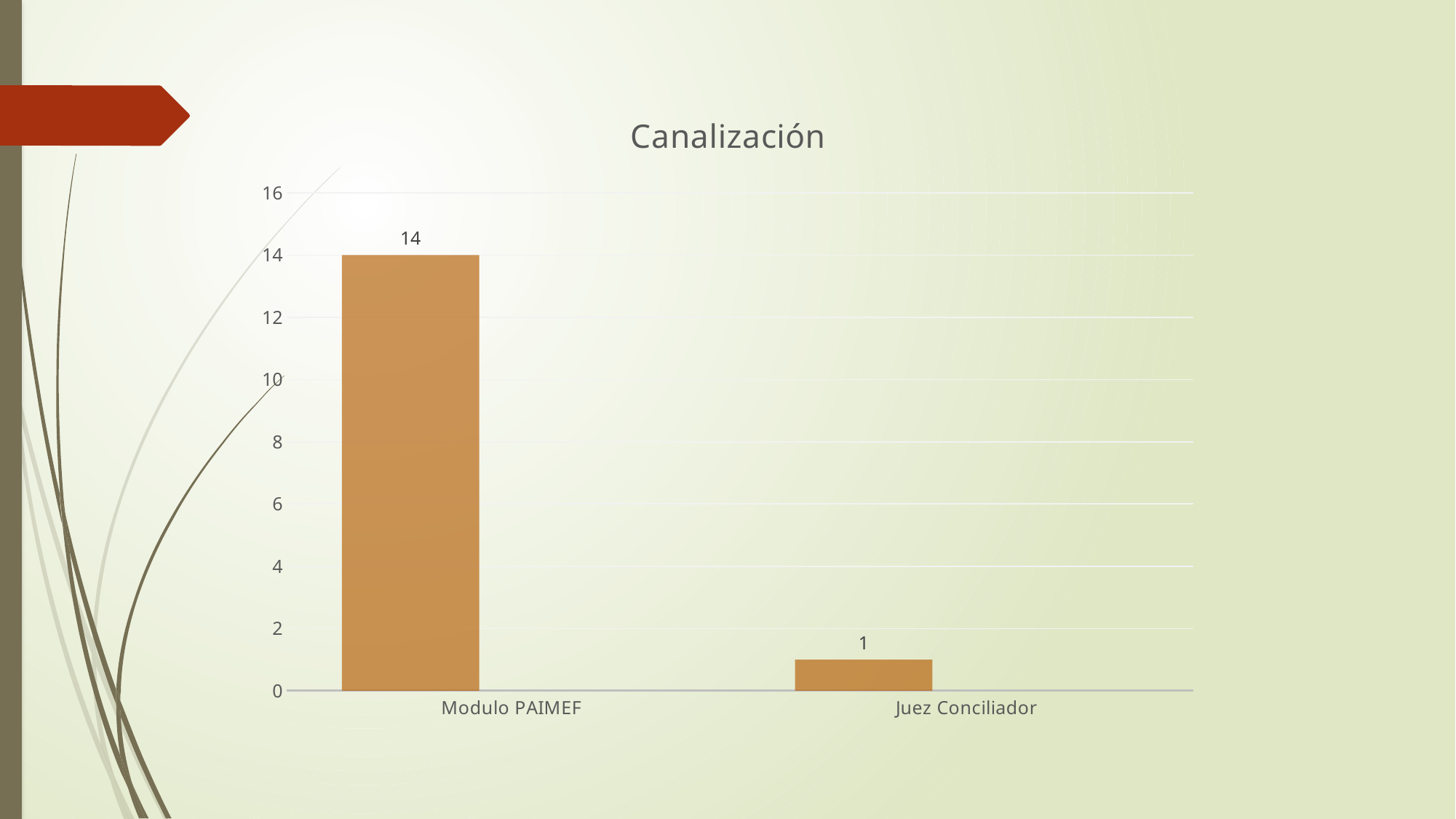
How many categories are shown on the x axis? 2 What is the difference between the values for Modulo PAIMEF and Juez Conciliador? 13 What is the highest value shown on the y axis? 16 Which is larger, the value for Modulo PAIMEF or the value for Juez Conciliador? Modulo PAIMEF What is the title of the chart? Canalización Which category has the lowest value? Juez Conciliador Which category has the highest value? Modulo PAIMEF Is the value for Modulo PAIMEF greater or less than 10? greater What is the value for Juez Conciliador? 1 What kind of chart is shown on the slide? bar chart What is the value for Modulo PAIMEF? 14 Is the value for Juez Conciliador greater or less than 4? less